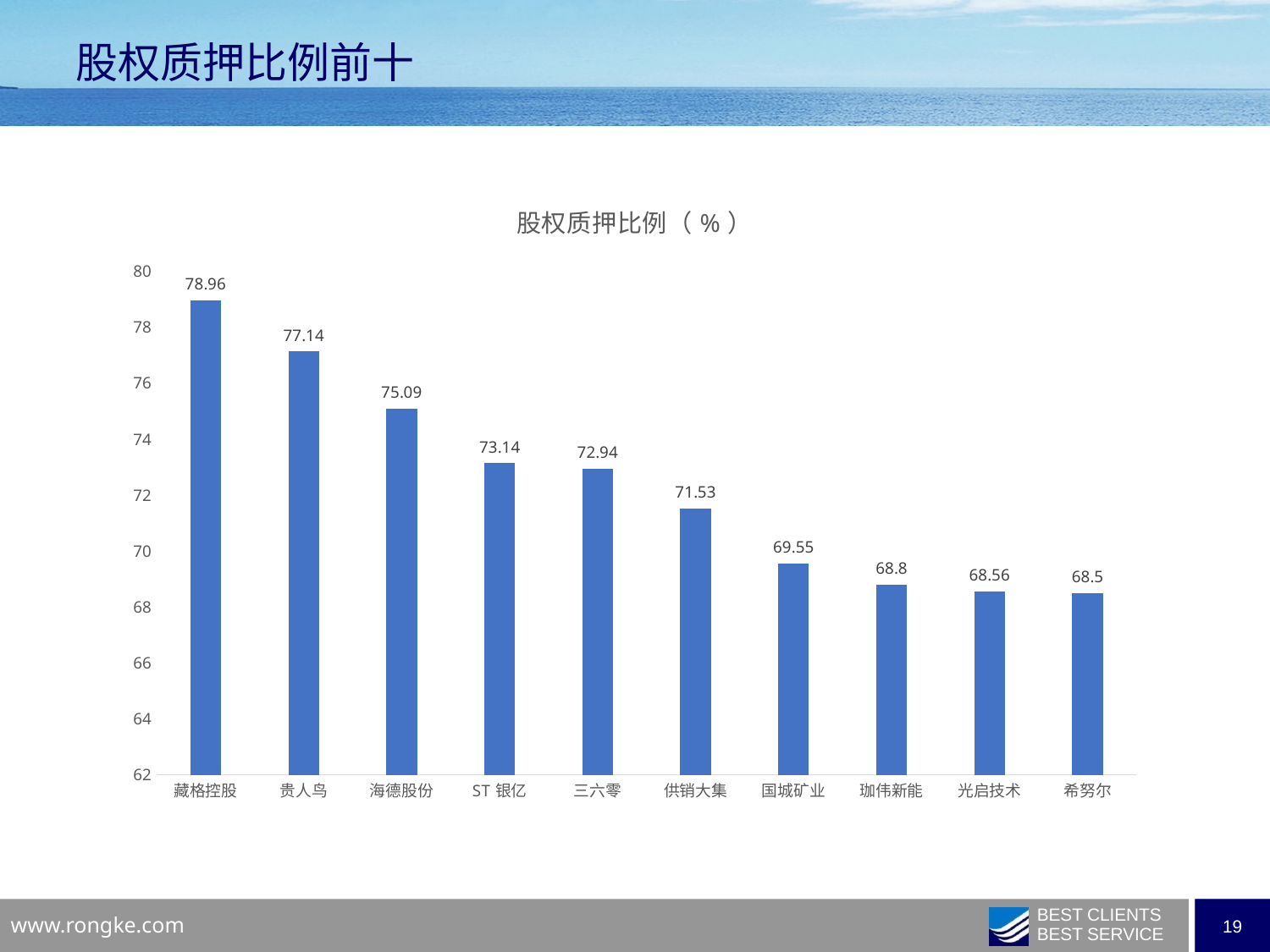
What kind of chart is shown on the slide? bar chart What is the title of the chart? 股权质押比例（%） Is the value for 供销大集 greater or less than 70? greater What is the difference between the values for 海德股份 and 供销大集? 3.56 What is the value for 三六零? 72.94 What is the value for 藏格控股? 78.96 Which category has the lowest value? 希努尔 Which category has the highest value? 藏格控股 Which is larger, the value for ST 银亿 or the value for 国城矿业? ST 银亿 What is the value for 珈伟新能? 68.8 How many categories are shown in the chart? 10 What is the difference between the values for 藏格控股 and 贵人鸟? 1.82